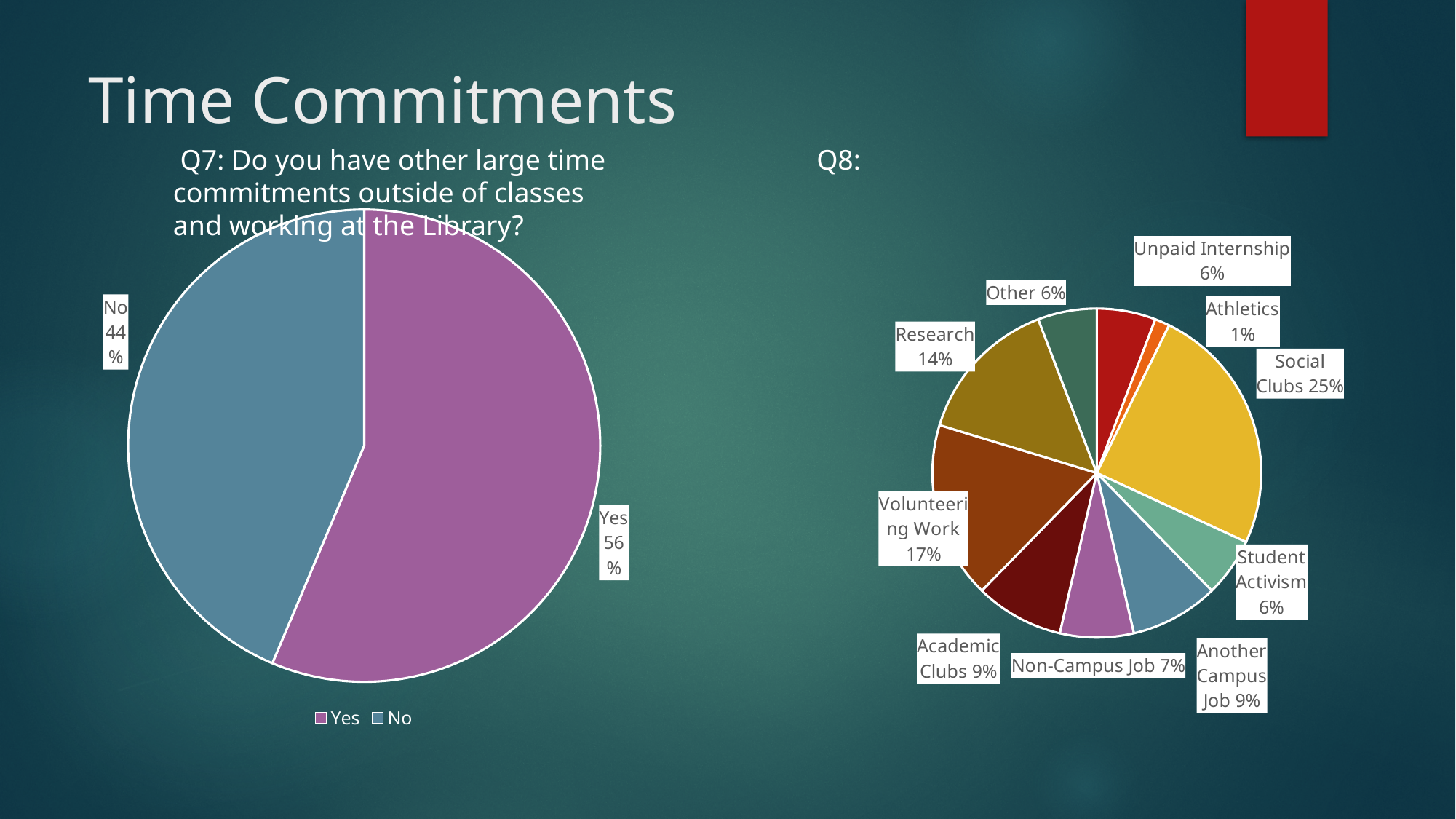
How many entries does the legend of the Q7 pie chart on the left list? 2 In the Q8 pie chart on the right, what is the share for Volunteering Work? 17% In the Q7 pie chart on the left, which answer has the larger share, Yes or No? Yes In the Q8 pie chart on the right, how many categories (slices) are shown? 10 In the Q7 pie chart on the left, what share of respondents answered Yes? 56% In the Q8 pie chart on the right, what is the share for Research? 14% In the Q7 pie chart on the left, what share of respondents answered No? 44% In the Q7 pie chart on the left, how many percentage points larger is the Yes share than the No share? 12 In the Q8 pie chart on the right, which category has the smallest share? Athletics In the Q8 pie chart on the right, how many percentage points larger is Social Clubs than Non-Campus Job? 18 What kind of chart is the Q8 chart on the right? Pie chart In the Q8 pie chart on the right, which category has the largest share? Social Clubs